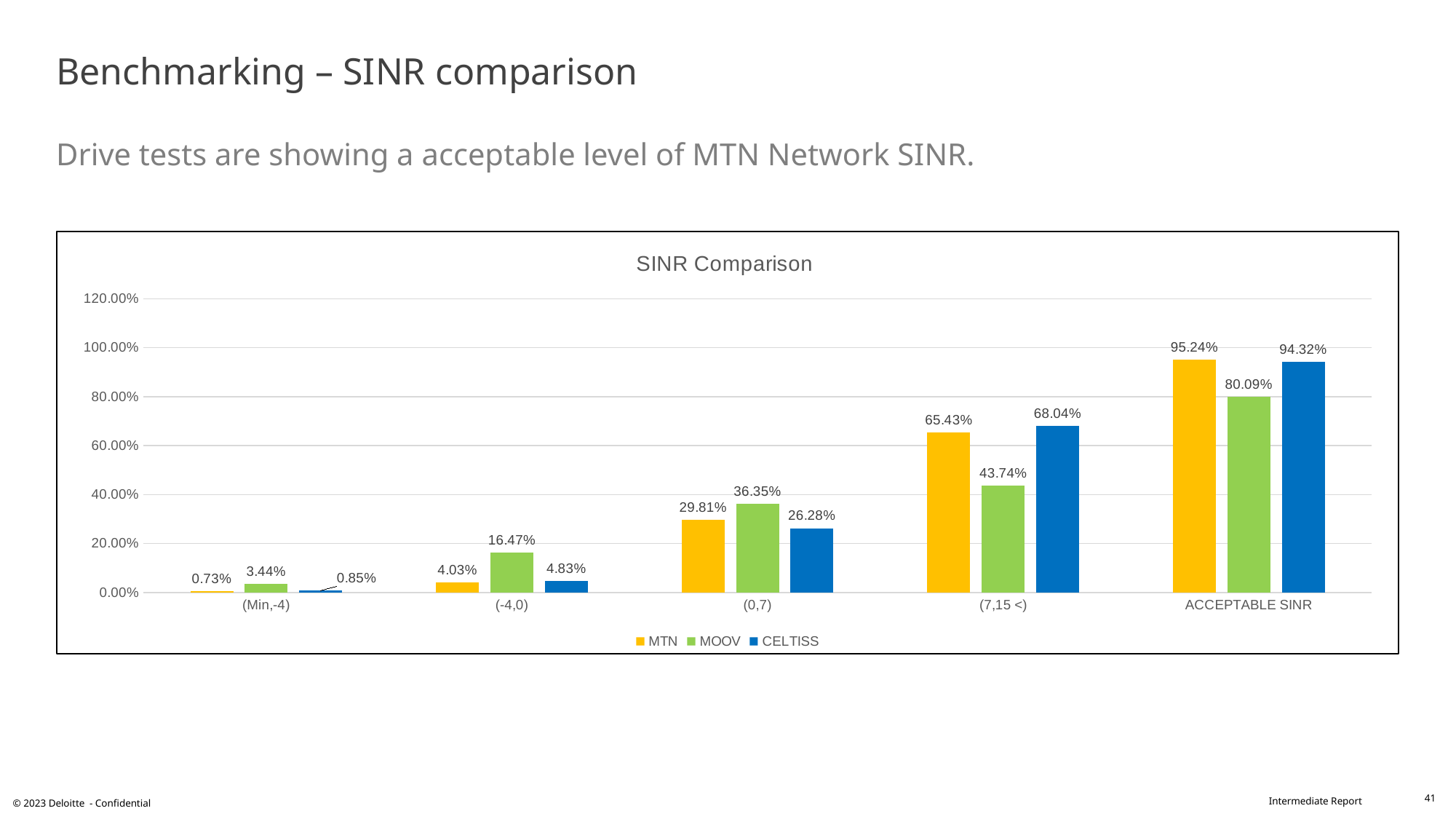
How many series does the legend list? 3 What is the difference between the MTN and MOOV values in the ACCEPTABLE SINR category? 15.15% What is the MOOV value for the (-4,0) category? 16.47% What is the MTN value for the ACCEPTABLE SINR category? 95.24% Which is larger in the (0,7) category, the MTN value or the MOOV value? MOOV Which series has the highest value in the (7,15 <) category? CELTISS What is the CELTISS value for the (0,7) category? 26.28% Do the MTN values rise or fall from (Min,-4) to ACCEPTABLE SINR? Rise What kind of chart is shown? Bar chart What is the title of the chart? SINR Comparison How many categories are shown on the x axis? 5 Which series has the lowest value in the (Min,-4) category? MTN